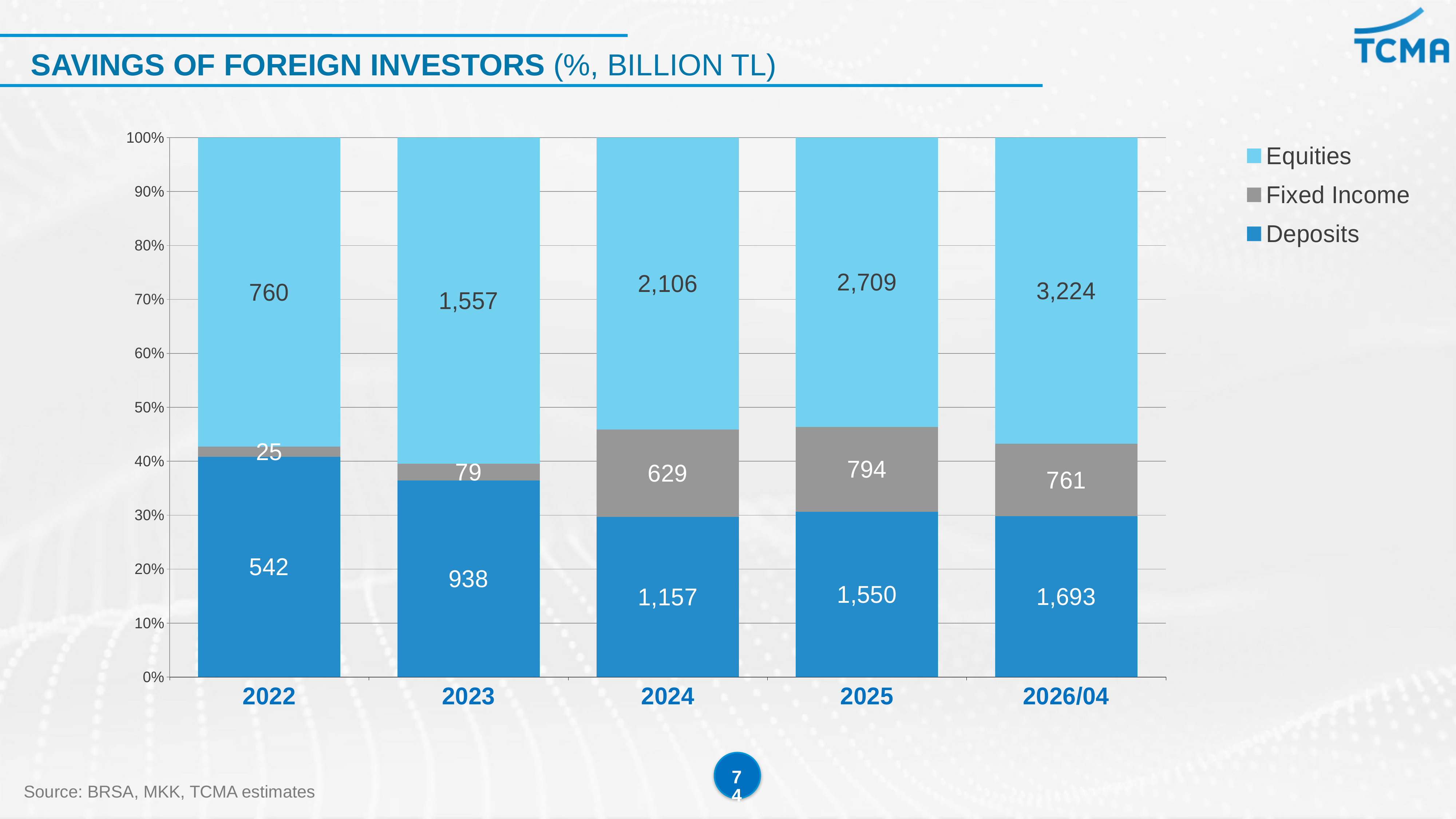
What kind of chart is shown on the slide? Stacked bar chart Is the share of Equities in 2022 greater or less than 50%? greater What is the total of the labelled values for the 2022 bar? 1,327 What is the value for Equities in 2024? 2,106 How many series does the legend list? 3 What is the value for Deposits in 2026/04? 1,693 What is the difference between the Equities values for 2026/04 and 2025? 515 What is the value for Fixed Income in 2022? 25 Which is larger, Deposits in 2023 or Fixed Income in 2025? Deposits in 2023 In which year is the Deposits value lowest? 2022 How many years are shown on the x axis? 5 In which year is the Fixed Income value highest? 2025